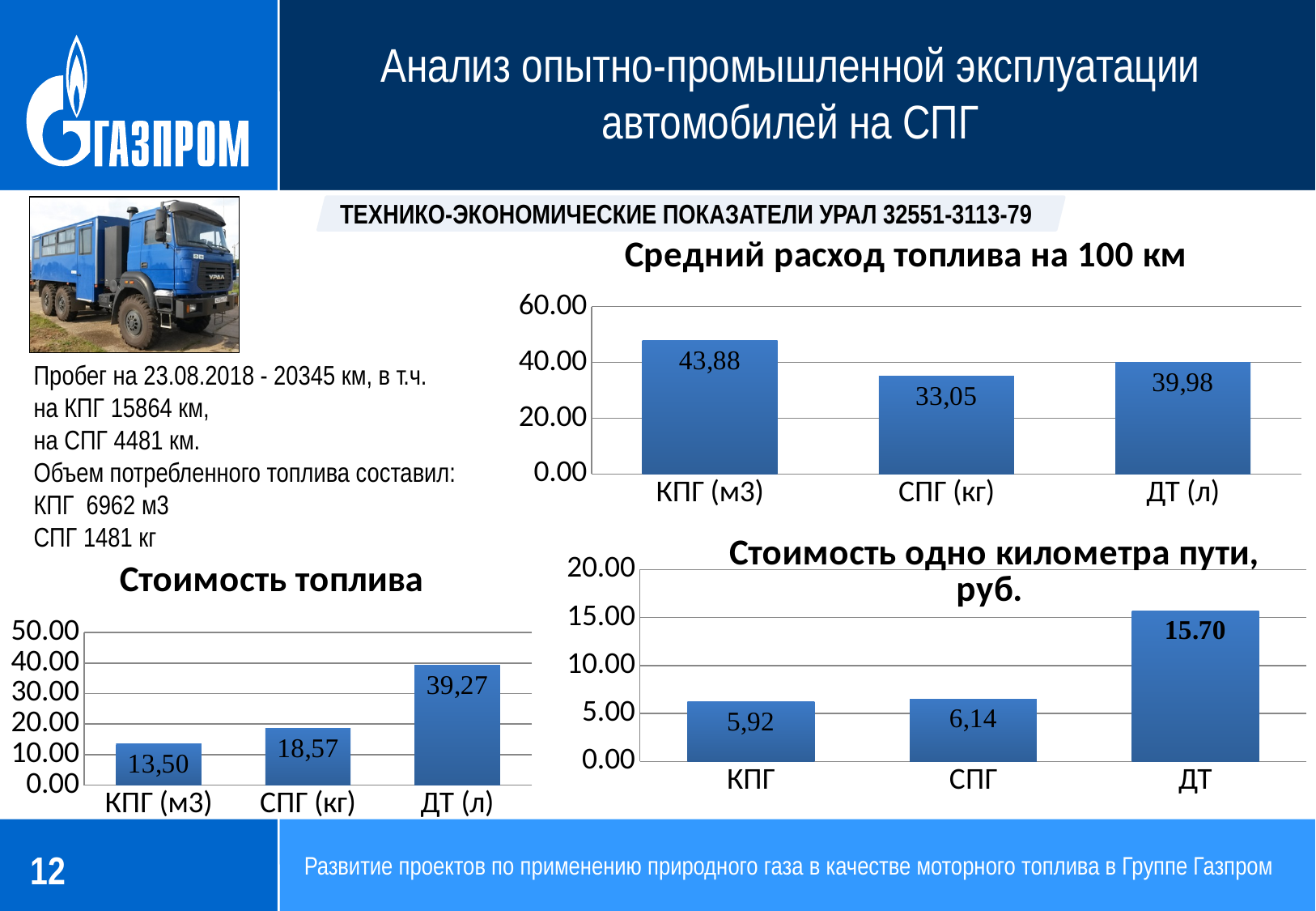
In the chart 'Средний расход топлива на 100 км', which category has the lowest value? СПГ (кг) In the chart 'Стоимость топлива', which category has the highest value? ДТ (л) In the chart 'Средний расход топлива на 100 км', what is the value for КПГ (м3)? 43,88 In the chart 'Стоимость одно километра пути, руб.', what is the difference between the values for СПГ and КПГ? 0,22 In the chart 'Стоимость топлива', what is the value for СПГ (кг)? 18,57 In the chart 'Средний расход топлива на 100 км', what is the difference between the values for КПГ (м3) and СПГ (кг)? 10,83 In the chart 'Стоимость топлива', how many categories are shown? 3 In the chart 'Стоимость топлива', what is the difference between the values for ДТ (л) and КПГ (м3)? 25,77 In the chart 'Стоимость одно километра пути, руб.', is the value for ДТ greater or less than 10.00? greater In the chart 'Стоимость одно километра пути, руб.', which is larger, the value for КПГ or the value for СПГ? СПГ In the chart 'Стоимость одно километра пути, руб.', what is the value for ДТ? 15.70 What type of chart is 'Средний расход топлива на 100 км'? bar chart